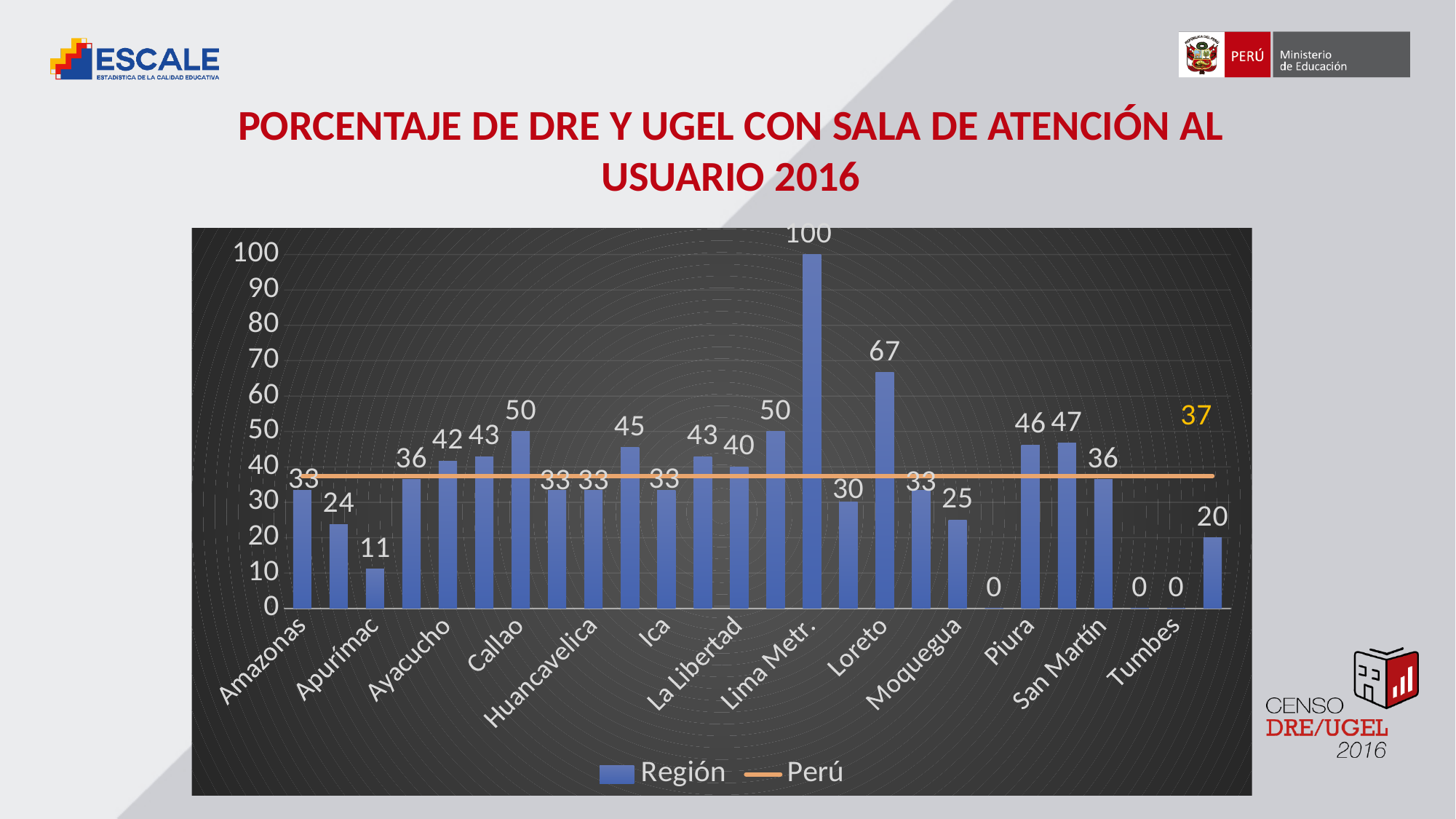
Which region has the highest value? Lima Metr. What is the difference between the values for Loreto and Callao? 17 What kind of chart is this? bar chart with a line What are the two entries in the legend? Región and Perú Is the value for Moquegua greater or less than 30? less What is the value for Loreto? 67 How many series does the legend list? 2 What is the value for Lima Metr.? 100 What value does the Perú line show? 37 Which has a larger value, Piura or San Martín? Piura What is the value for Apurímac? 11 What is the value for Tumbes? 0